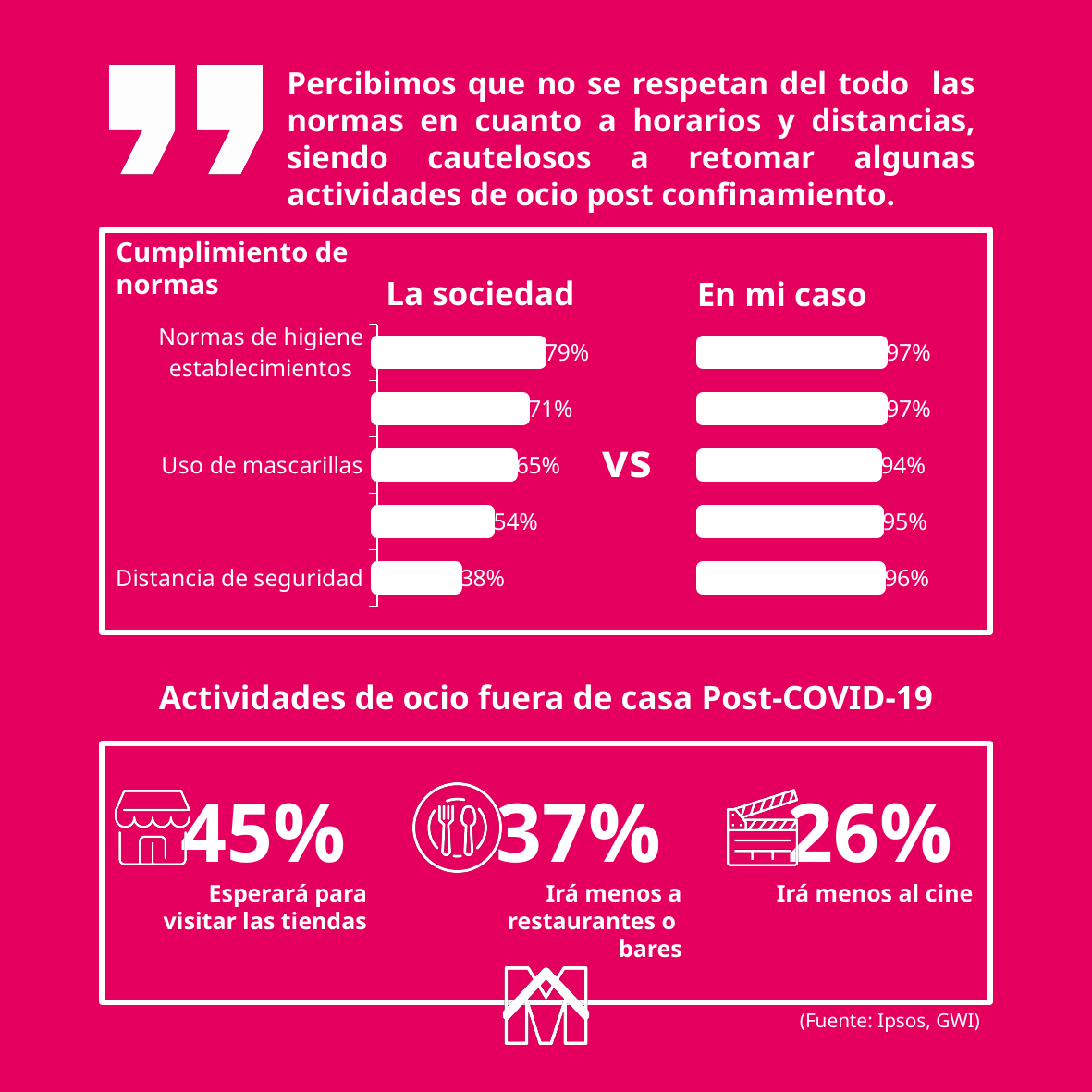
In the 'En mi caso' chart, what is the value for Normas de higiene establecimientos? 97% In the 'La sociedad' chart, what is the value for Normas de higiene establecimientos? 79% What type of chart is used in the 'Cumplimiento de normas' section? Bar chart In the 'En mi caso' chart, what is the value for Uso de mascarillas? 94% What is the difference between the 'En mi caso' and 'La sociedad' values for Distancia de seguridad? 58% In the 'La sociedad' chart, what is the value for Uso de mascarillas? 65% How many bars does the 'La sociedad' chart show? 5 In the 'La sociedad' chart, what is the value for Distancia de seguridad? 38% For Uso de mascarillas, which is larger: the 'La sociedad' value or the 'En mi caso' value? En mi caso In the 'La sociedad' chart, which bar has the highest value? Normas de higiene establecimientos In the 'La sociedad' chart, which bar has the lowest value? Distancia de seguridad In the 'En mi caso' chart, what is the value for Distancia de seguridad? 96%